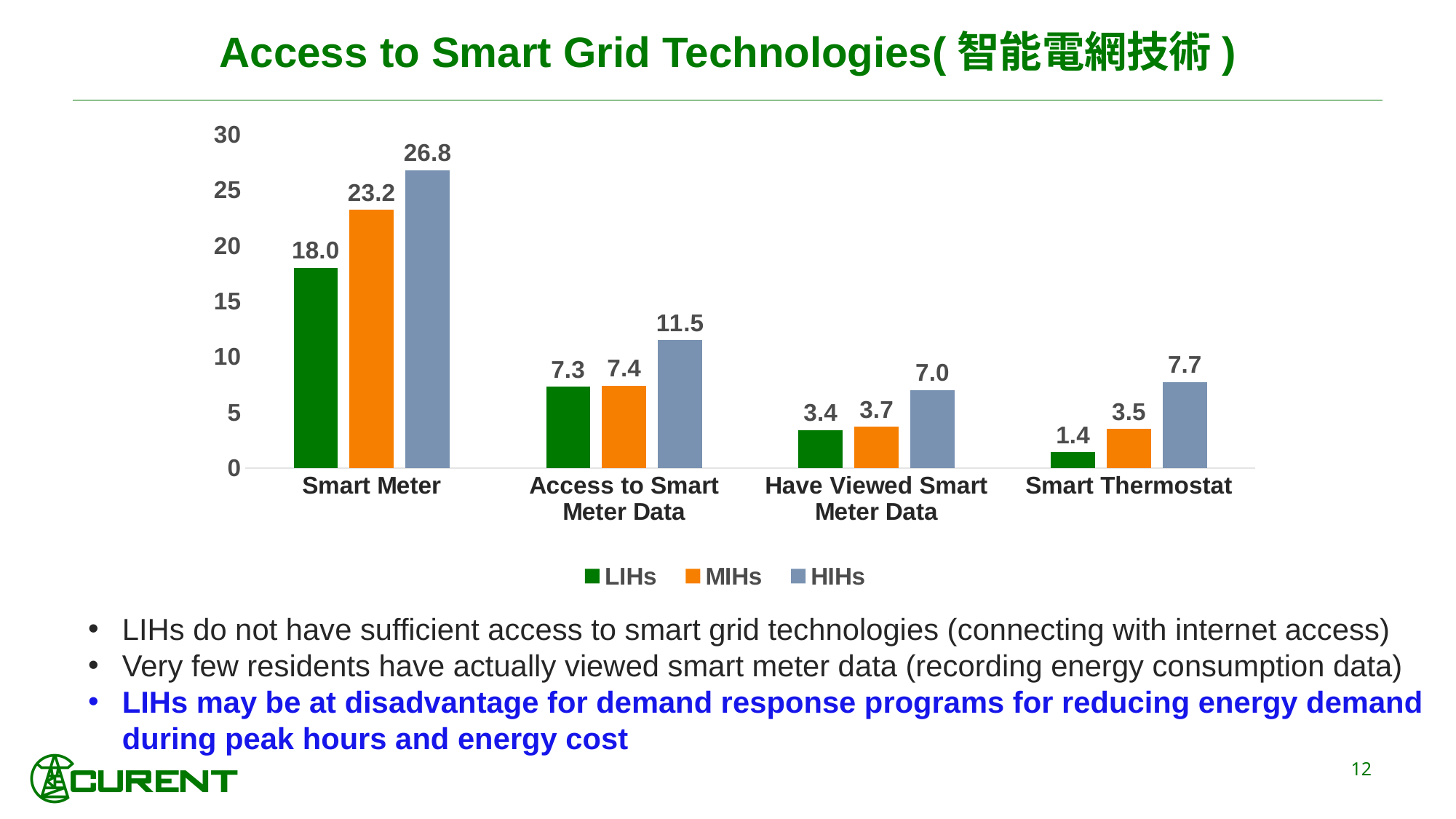
What is the value for LIHs in the Smart Thermostat category? 1.4 Which is larger in the Access to Smart Meter Data category: the value for LIHs or the value for HIHs? HIHs What is the value for HIHs in the Smart Meter category? 26.8 Which category has the highest value for LIHs? Smart Meter What kind of chart is shown on the slide? bar chart How many categories are shown on the x axis? 4 What is the difference between the HIHs and LIHs values in the Smart Meter category? 8.8 How many series does the legend list? 3 What colour are the bars for MIHs? orange Which category has the lowest value for HIHs? Have Viewed Smart Meter Data Is the value for MIHs in the Smart Meter category greater or less than 20? greater What is the value for MIHs in the Have Viewed Smart Meter Data category? 3.7